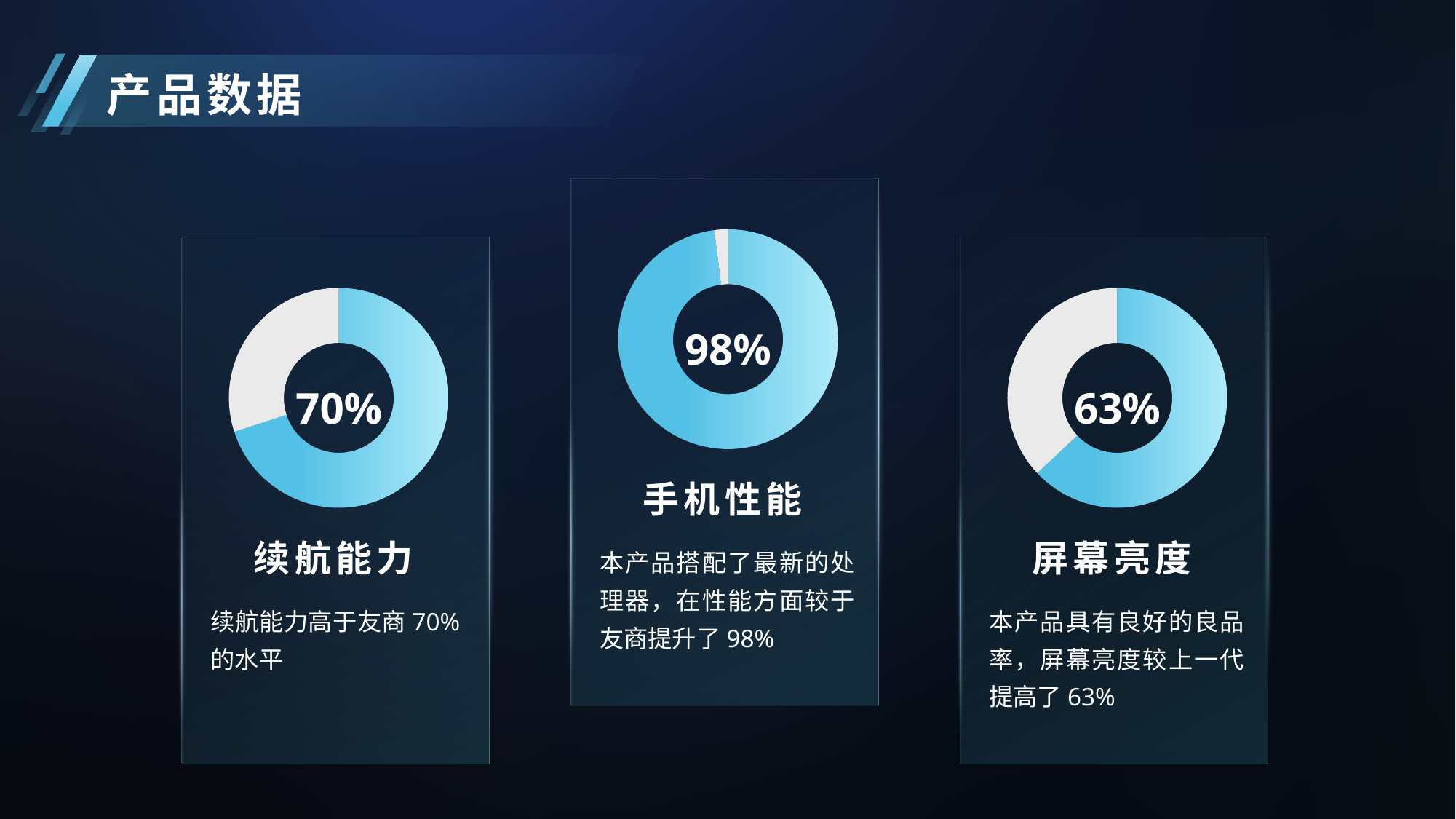
How many donut charts are on the slide? 3 What is the difference between the percentage in the 手机性能 chart and the percentage in the 续航能力 chart? 28% Which of the three donut charts shows the highest percentage? 手机性能 What percentage is shown in the centre of the 屏幕亮度 donut chart? 63% Which is larger, the percentage in the 续航能力 chart or the percentage in the 屏幕亮度 chart? 续航能力 What percentage is shown in the centre of the 续航能力 donut chart? 70% What kind of chart is used for 手机性能? Donut (pie) chart What is the difference between the percentage in the 续航能力 chart and the percentage in the 屏幕亮度 chart? 7% In the 屏幕亮度 donut chart, what share of the ring is filled in blue? 63% What is the title of the slide? 产品数据 Which of the three donut charts shows the lowest percentage? 屏幕亮度 What percentage is shown in the centre of the 手机性能 donut chart? 98%